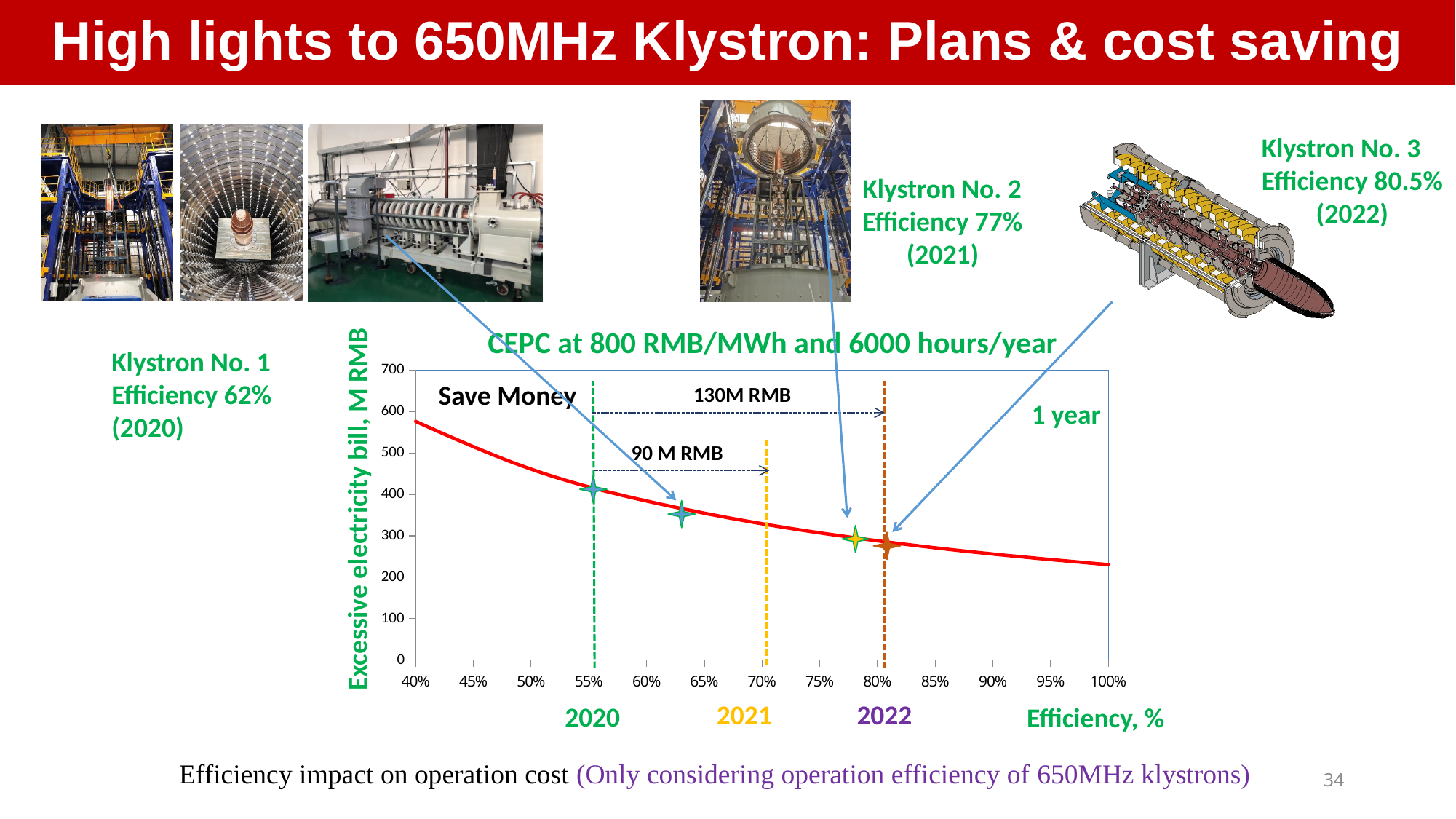
How many tick labels are shown on the chart's x axis? 13 What saving is annotated between the 2020 and 2022 dashed lines on the chart? 130M RMB Is the excessive electricity bill at 40% efficiency greater or less than 500? greater What saving is annotated between the 2020 and 2021 dashed lines on the chart? 90 M RMB What is the title of the chart? CEPC at 800 RMB/MWh and 6000 hours/year Does the excessive electricity bill rise or fall as efficiency increases along the x axis? fall What kind of chart is shown on the slide? line chart Is the excessive electricity bill at 100% efficiency greater or less than 300? less Is the excessive electricity bill at 50% efficiency greater or less than 400? greater What is the label of the chart's vertical axis? Excessive electricity bill, M RMB Which is larger, the excessive electricity bill at 50% efficiency or at 90% efficiency? 50% efficiency